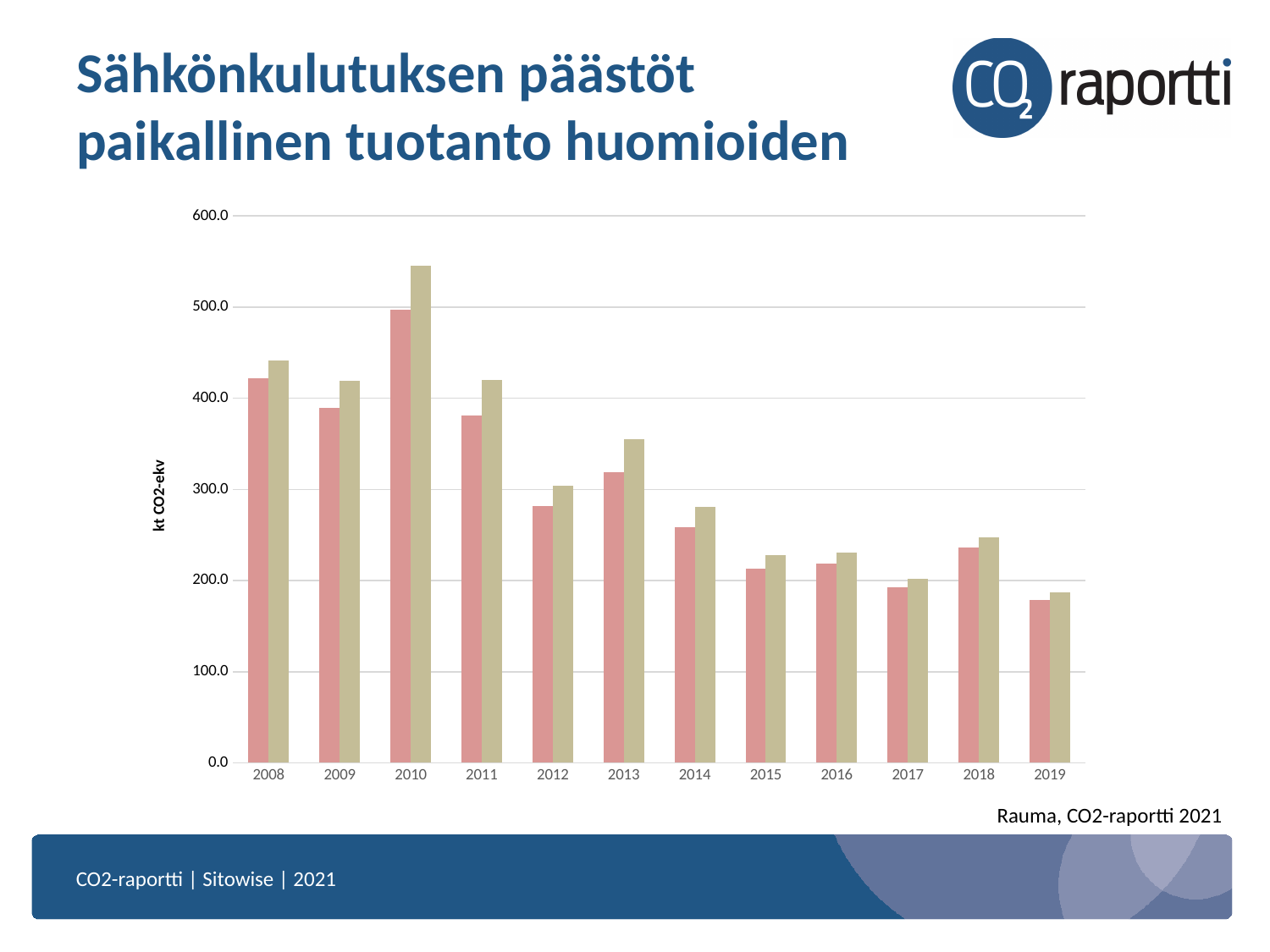
What kind of chart is shown on the slide? bar chart How many bars are plotted for each year in the chart? 2 Do the values of the pink bars generally rise or fall from 2010 to 2019? fall Is the value of the tan bar for 2010 greater or less than 500? greater Is the value of the tan bar for 2013 greater or less than 400? less What unit is shown on the y axis of the chart? kt CO2-ekv How many years are shown on the x axis of the chart? 12 Is the value of the pink bar for 2012 greater or less than 300? less Which year has the highest value for the pink bars? 2010 Which is larger in 2008, the pink bar or the tan bar? the tan bar Which year has the lowest value for the tan bars? 2019